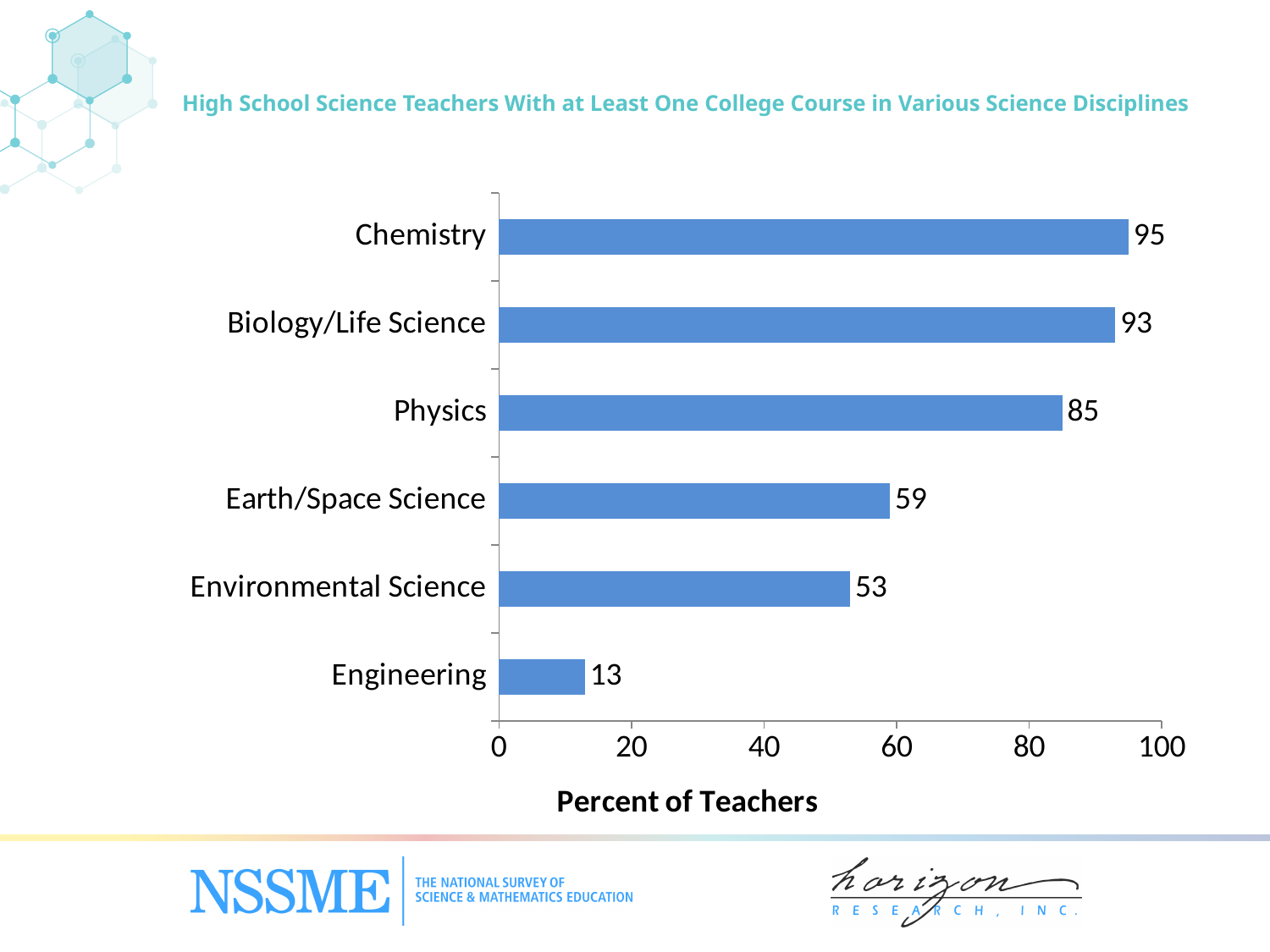
Which discipline has the highest percent of teachers? Chemistry What is the value for Engineering? 13 What is the label of the horizontal axis? Percent of Teachers Is the value for Physics greater or less than 80? greater What kind of chart is shown on the slide? Bar chart What is the difference between the values for Physics and Environmental Science? 32 How many disciplines are shown in the chart? 6 Which is larger, the value for Earth/Space Science or the value for Environmental Science? Earth/Space Science What percent of teachers have at least one college course in Chemistry? 95 What is the value for Earth/Space Science? 59 What is the difference between the values for Chemistry and Engineering? 82 Which discipline has the lowest percent of teachers? Engineering